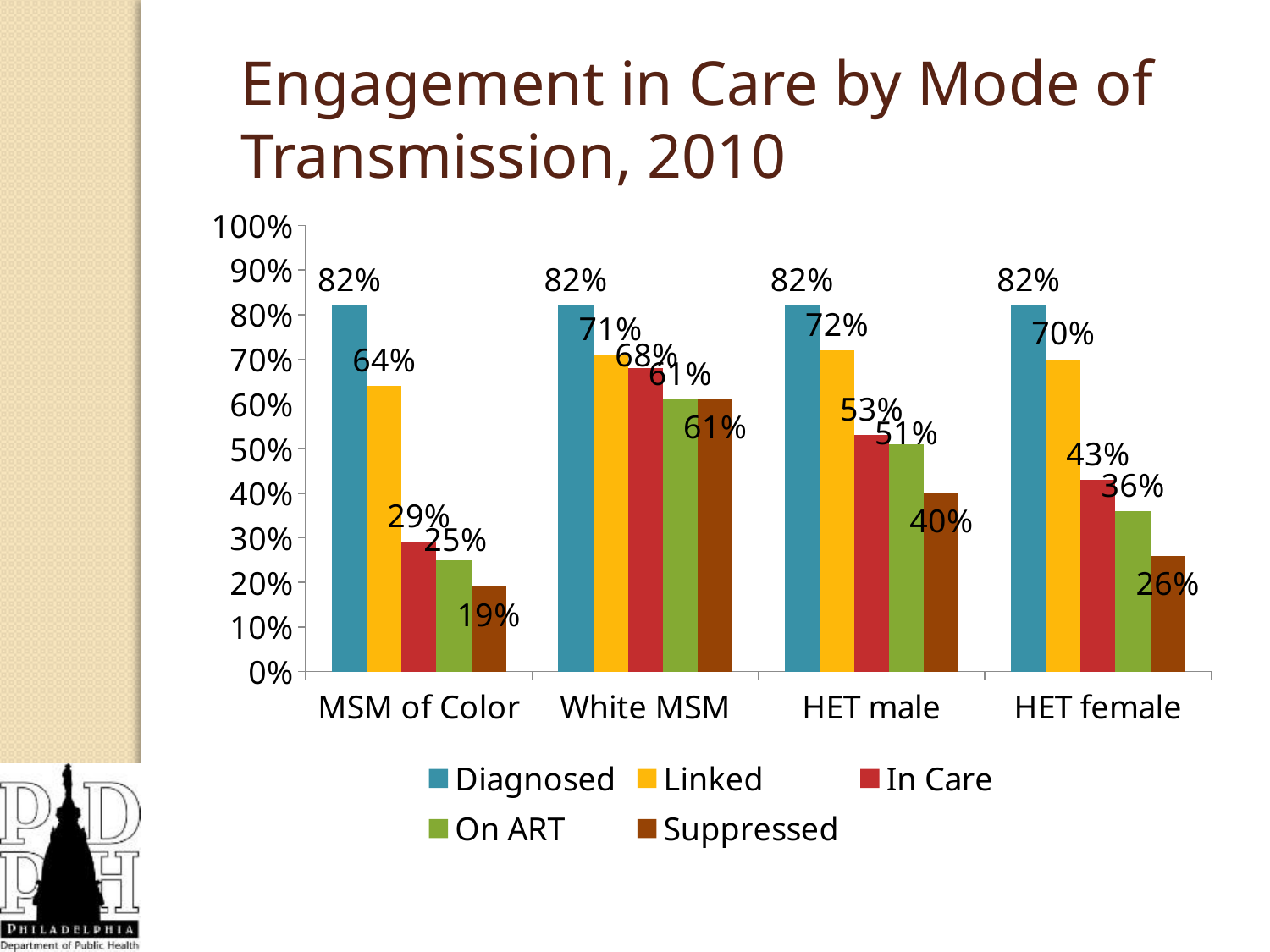
Which mode of transmission has the lowest Suppressed value? MSM of Color Which series is shown in yellow in the legend? Linked What is the Suppressed value for HET male? 40% What is the In Care value for HET female? 43% What is the On ART value for White MSM? 61% What is the Linked value for MSM of Color? 64% Which is larger, the Suppressed value for HET male or the Suppressed value for HET female? HET male What is the difference between the Diagnosed and Linked values for HET female? 12% How many modes of transmission are shown on the x axis? 4 Which mode of transmission has the highest In Care value? White MSM What kind of chart is shown on the slide? Bar chart How many series does the legend list? 5